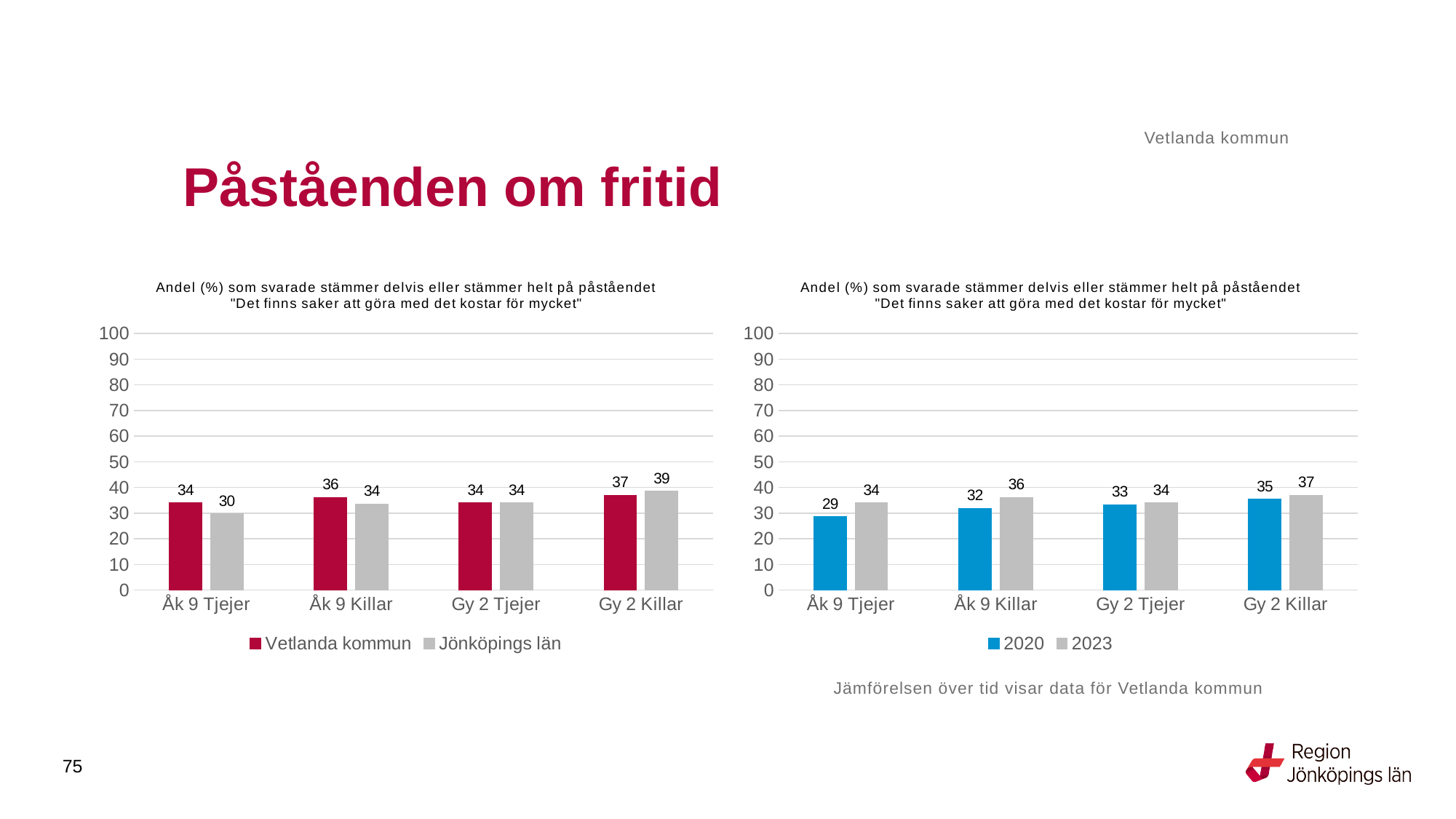
In the left chart, which category has the highest value for Jönköpings län? Gy 2 Killar In the right chart, how many categories are shown on the x axis? 4 In the right chart, which category has the lowest value for 2020? Åk 9 Tjejer In the left chart, what is the value for Jönköpings län for Åk 9 Tjejer? 30 In the right chart, what is the value for 2020 for Åk 9 Tjejer? 29 What type of chart is the right chart? Bar chart In the right chart, do the 2020 values rise or fall from Åk 9 Tjejer to Gy 2 Killar? Rise In the right chart, what is the value for 2023 for Gy 2 Killar? 37 In the left chart, which is larger for Gy 2 Killar: Vetlanda kommun or Jönköpings län? Jönköpings län In the left chart, how many series does the legend list? 2 In the left chart, what is the value for Vetlanda kommun for Åk 9 Killar? 36 In the right chart, what is the difference between the 2023 and 2020 values for Åk 9 Tjejer? 5